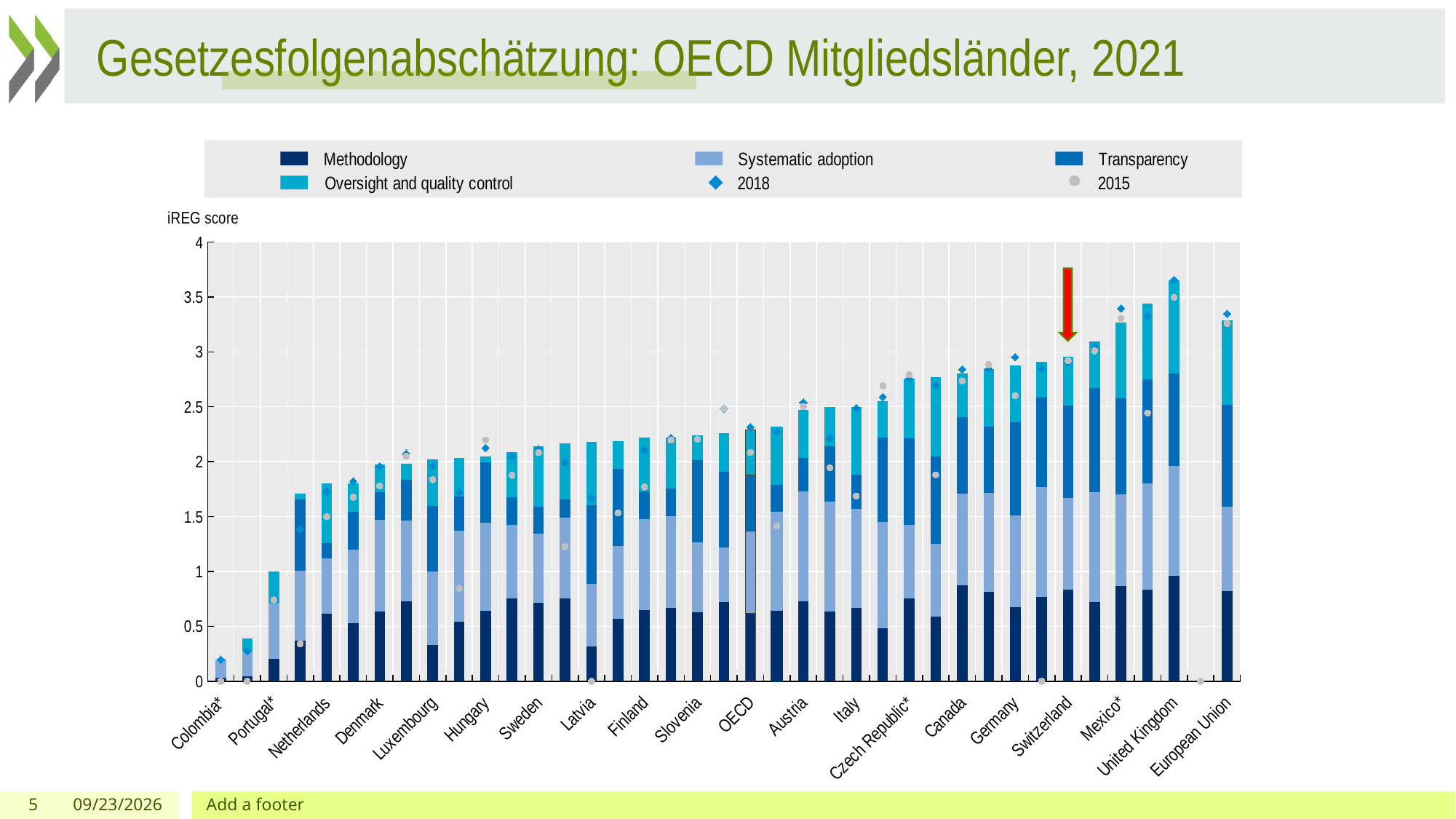
What is the label shown above the vertical axis of the chart? iREG score Which labelled country has the lowest total iREG score? Colombia* How many entries does the chart legend list? 6 Is the total iREG score for Colombia* greater or less than 0.5? less Is the total iREG score for OECD greater or less than 2? greater Is the total iREG score for Netherlands greater or less than 1.5? greater Which has a larger total iREG score, United Kingdom or Portugal*? United Kingdom Which labelled country has the highest total iREG score? United Kingdom Do the total bar heights generally rise or fall from left to right along the x axis? rise What kind of chart is shown on the slide? bar chart